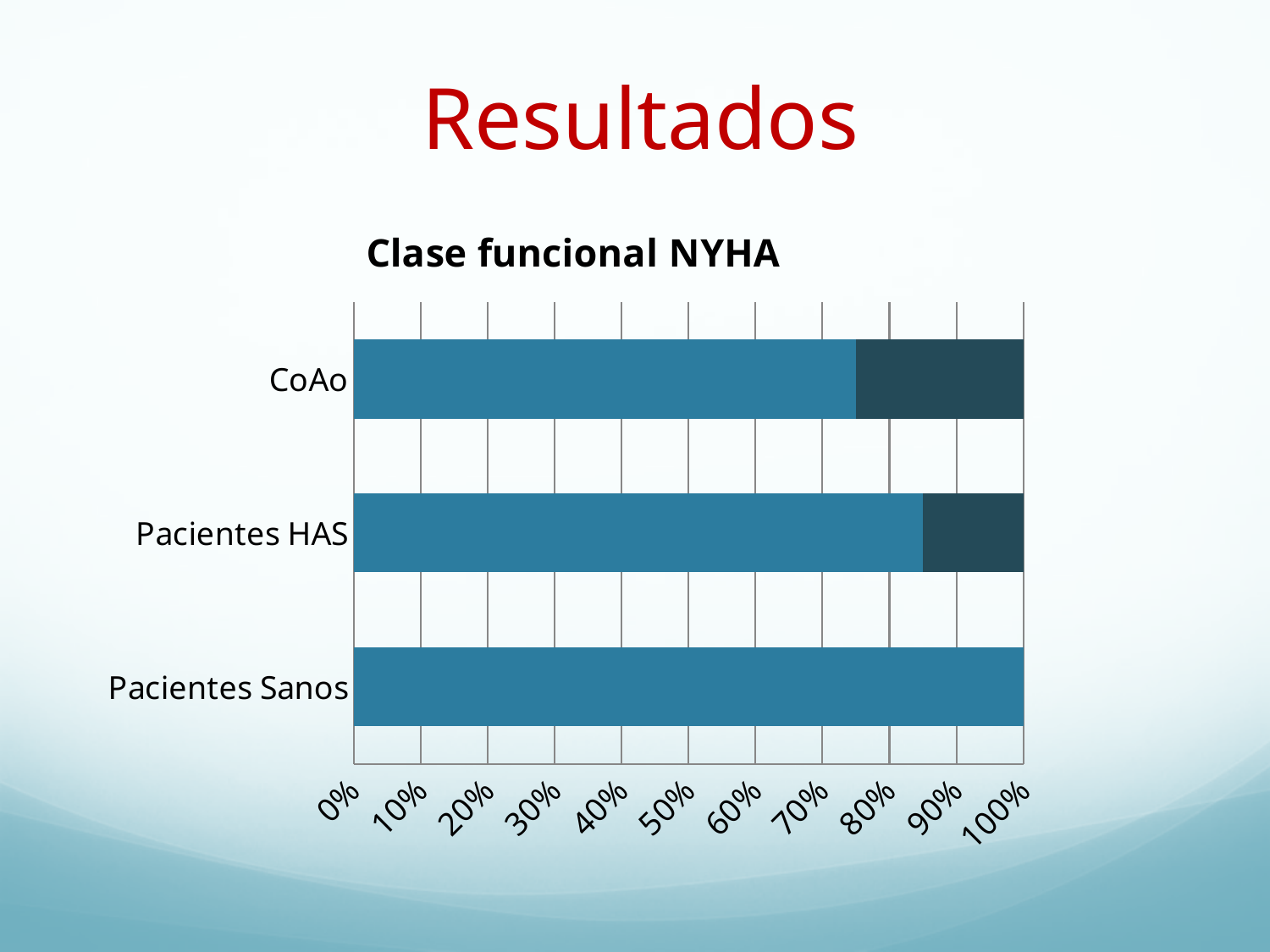
Is the light blue segment for CoAo greater or less than 80%? less Which has a larger light blue segment, CoAo or Pacientes HAS? Pacientes HAS Is the light blue segment for CoAo greater or less than 70%? greater What type of chart is shown on the slide? Stacked bar chart Which category has the shortest light blue segment? CoAo Which category has the largest dark blue segment? CoAo What value does the light blue bar for Pacientes Sanos reach on the axis? 100% Is the light blue segment for Pacientes HAS greater or less than 80%? greater How many categories are shown on the chart? 3 Which category has the longest light blue segment? Pacientes Sanos What is the title of the chart? Clase funcional NYHA